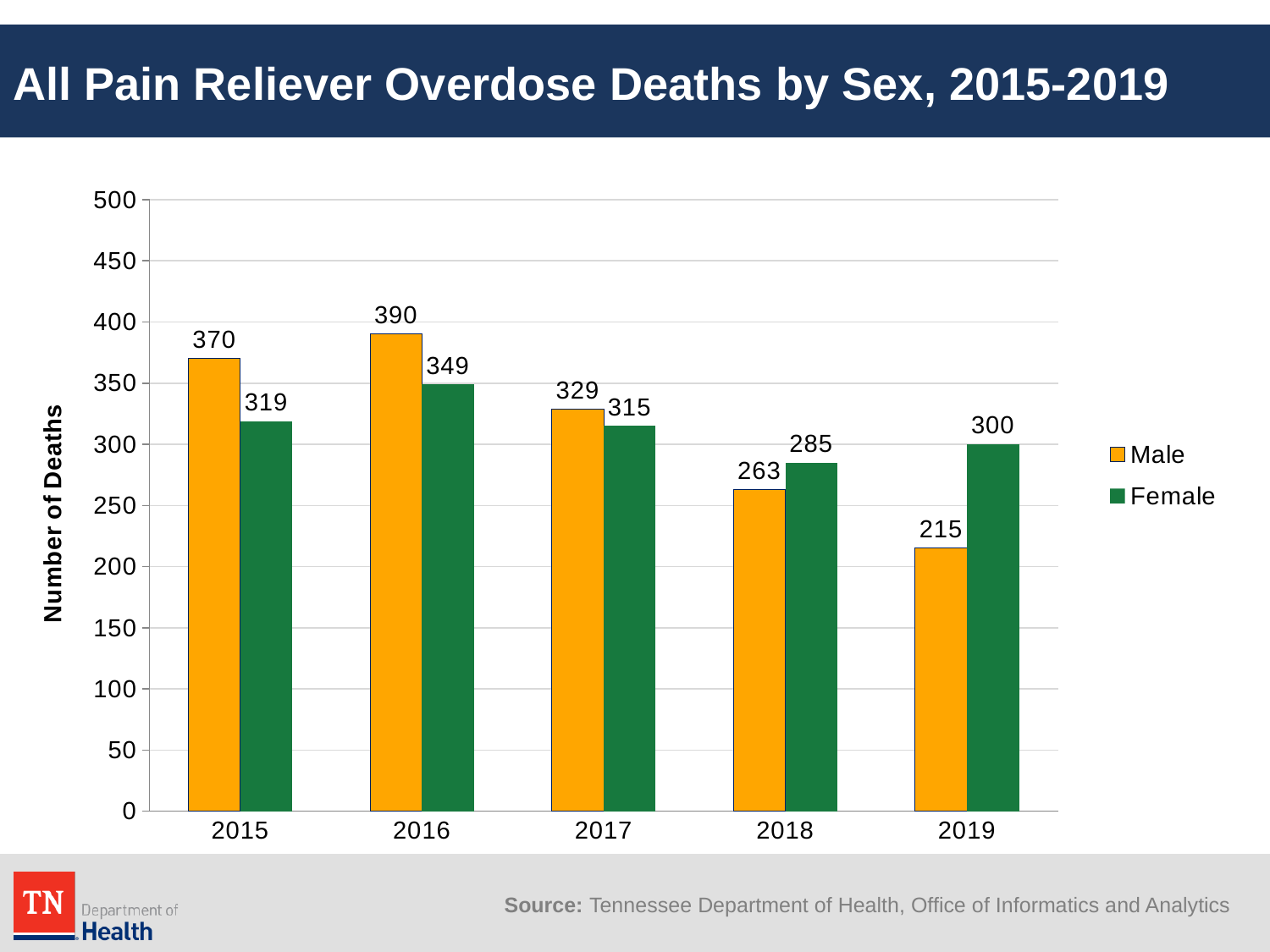
What is the difference between male and female overdose deaths in 2015? 51 What is the label of the y axis? Number of Deaths How many series does the legend list? 2 Which was larger in 2019, male or female overdose deaths? Female Do male overdose deaths rise or fall from 2016 to 2019? Fall In which year were male overdose deaths highest? 2016 How many years are shown on the x axis? 5 What kind of chart is shown on the slide? Bar chart What is the number of female pain reliever overdose deaths in 2019? 300 Is the value for male deaths in 2018 greater or less than 250? greater In which year were female overdose deaths lowest? 2018 What is the number of male pain reliever overdose deaths in 2016? 390